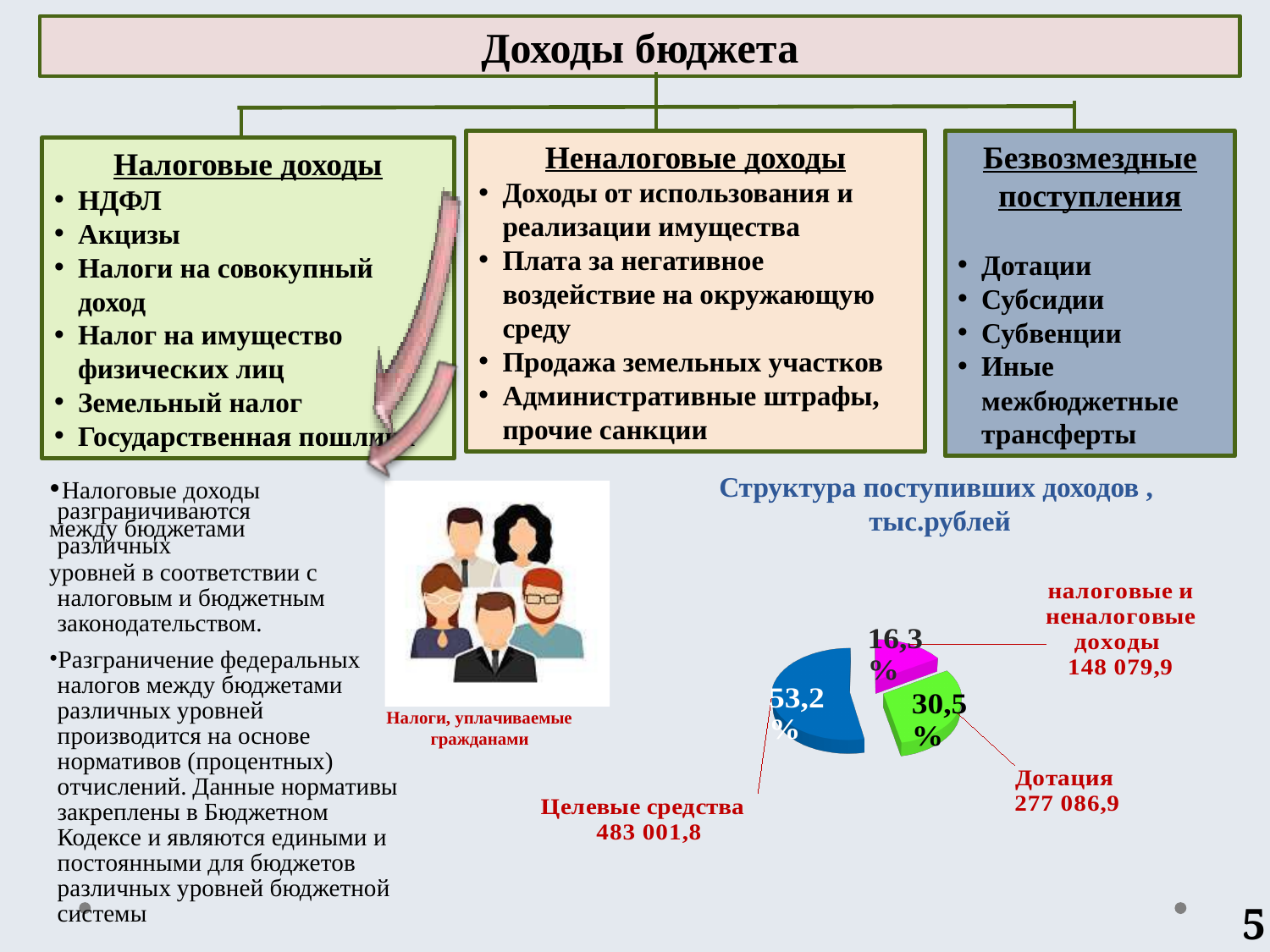
How many slices does the pie chart "Структура поступивших доходов" have? 3 In the pie chart, what share does "Дотация" have? 30,5% In the pie chart, what share does "налоговые и неналоговые доходы" have? 16,3% What kind of chart is shown under the title "Структура поступивших доходов, тыс.рублей"? pie chart In the pie chart, what is the value for "Дотация"? 277 086,9 In the pie chart, what is the value for "Целевые средства"? 483 001,8 Which category has the smallest slice in the pie chart? налоговые и неналоговые доходы In the pie chart, which is larger: "Дотация" or "налоговые и неналоговые доходы"? Дотация In the pie chart, what is the value for "налоговые и неналоговые доходы"? 148 079,9 In the pie chart, what share does "Целевые средства" have? 53,2% Which category has the largest slice in the pie chart? Целевые средства What is the title of the pie chart on the slide? Структура поступивших доходов , тыс.рублей